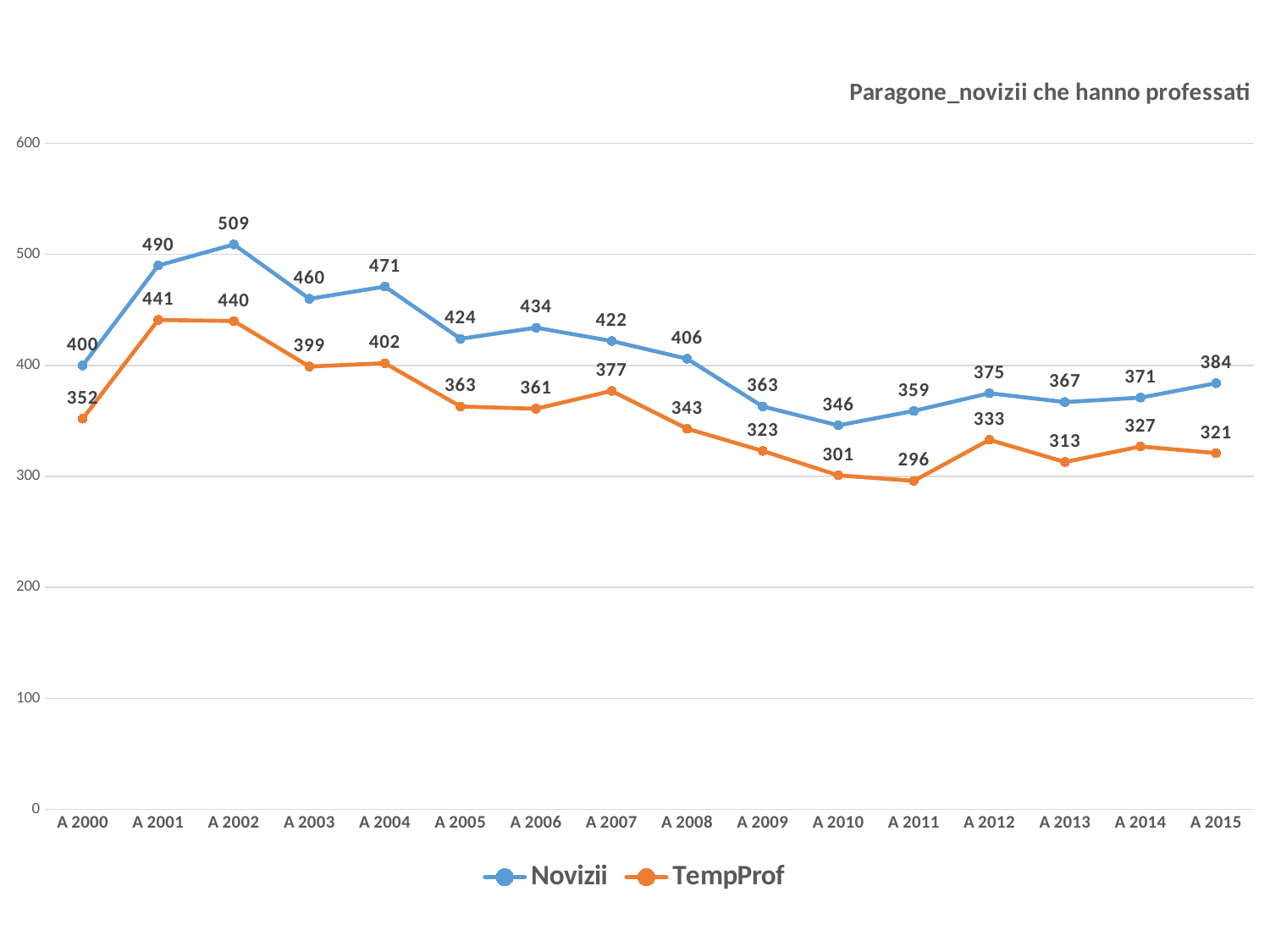
Which is larger in A 2015: the Novizii value or the TempProf value? Novizii What is the TempProf value for A 2011? 296 How many series does the legend list? 2 Is the TempProf value for A 2010 greater or less than 400? less In which year does the TempProf series reach its lowest value? A 2011 In which year does the Novizii series reach its highest value? A 2002 What kind of chart is shown on the slide? line chart Does the Novizii series rise or fall from A 2002 to A 2010? fall What is the difference between the Novizii and TempProf values in A 2000? 48 What is the title of the chart? Paragone_novizii che hanno professati How many years are shown on the x axis? 16 What is the Novizii value for A 2002? 509